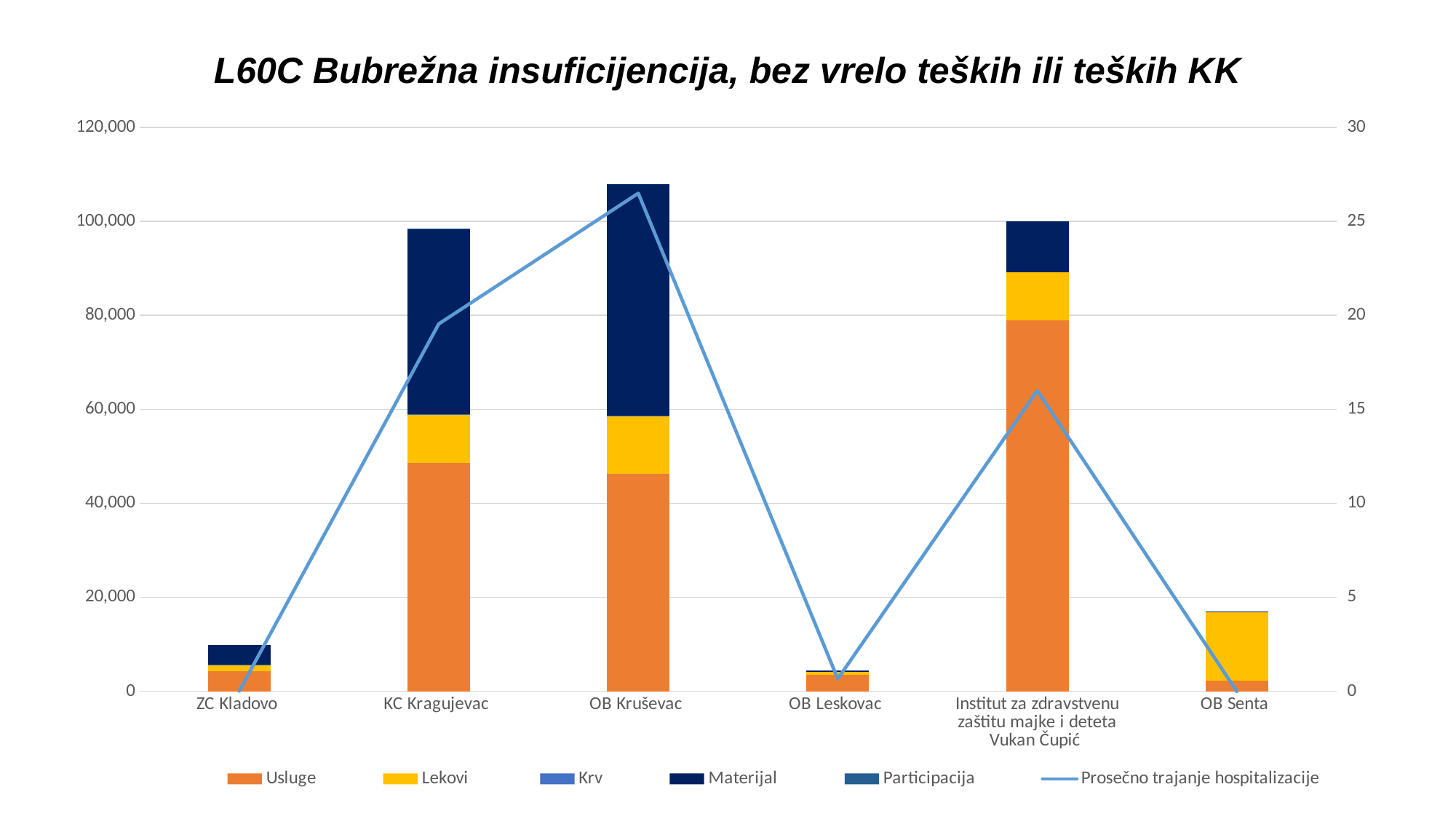
Is the total stacked bar for OB Senta greater or less than 20,000? less Which institution has the highest value on the Prosečno trajanje hospitalizacije line? OB Kruševac How many categories (institutions) are shown on the x axis? 6 What kind of chart is shown on the slide? Stacked bar chart with a line Which has the taller stacked bar, ZC Kladovo or OB Senta? OB Senta Which institution has the shortest stacked bar? OB Leskovac Which institution has the tallest stacked bar? OB Kruševac Is the total stacked bar for OB Kruševac greater or less than 100,000? greater How many series does the legend list? 6 Is the Prosečno trajanje hospitalizacije value for OB Kruševac greater or less than 25? greater What is the title of the chart? L60C Bubrežna insuficijencija, bez vrelo teških ili teških KK